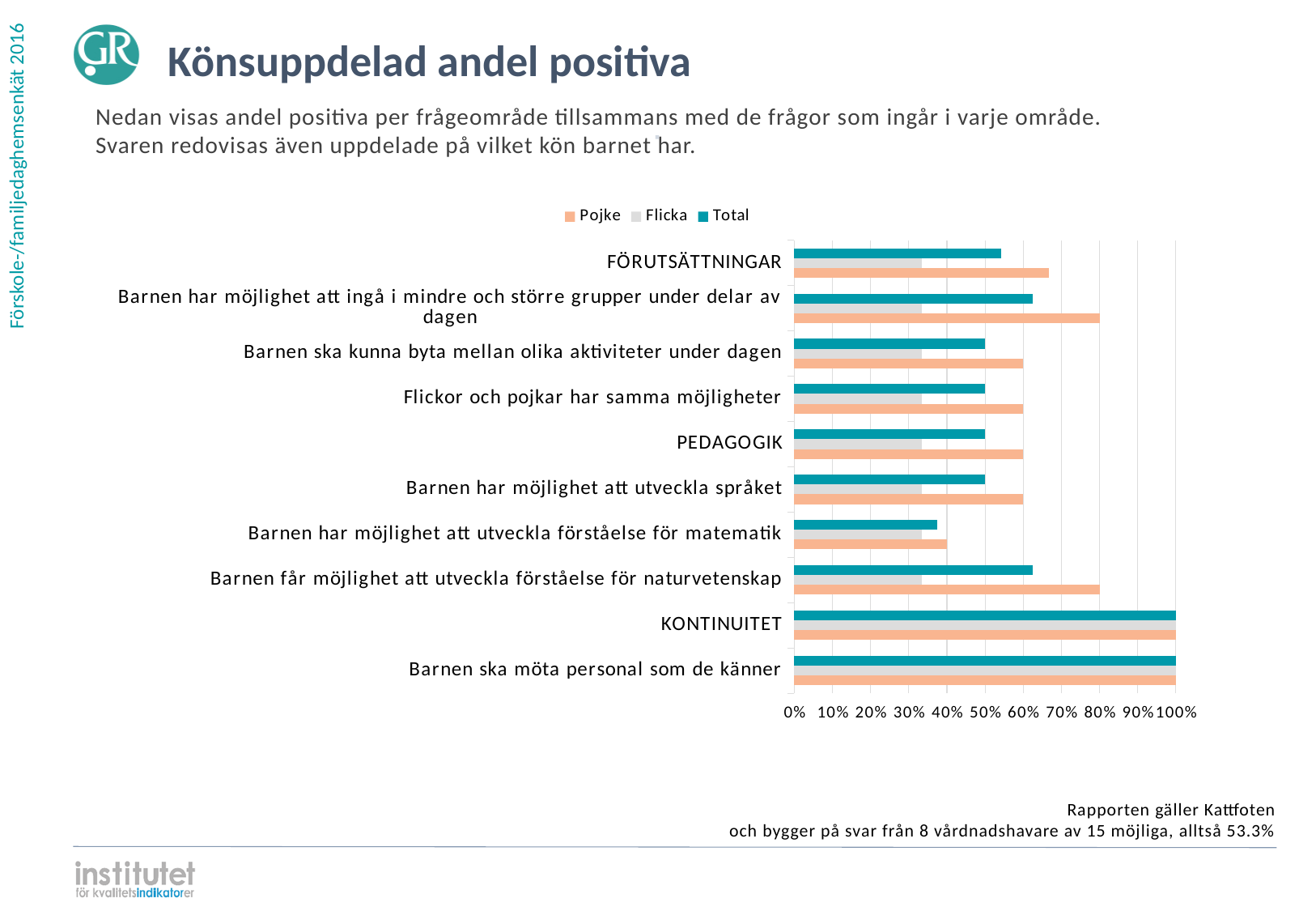
Which series is shown in orange in the legend? Pojke Is the Pojke value for PEDAGOGIK greater or less than 50%? greater How many categories are shown on the y axis of the chart? 10 Is the Pojke value for 'Barnen har möjlighet att ingå i mindre och större grupper under delar av dagen' greater or less than 70%? greater Is the Total value for 'Barnen har möjlighet att utveckla förståelse för matematik' greater or less than 40%? less What kind of chart is shown on the slide? bar chart How many series does the legend list? 3 Which category has the lowest Pojke value? Barnen har möjlighet att utveckla förståelse för matematik What is the Pojke value for 'Barnen ska möta personal som de känner'? 100% Which is larger for 'Barnen får möjlighet att utveckla förståelse för naturvetenskap': the Pojke value or the Flicka value? Pojke What is the Total value for KONTINUITET? 100%